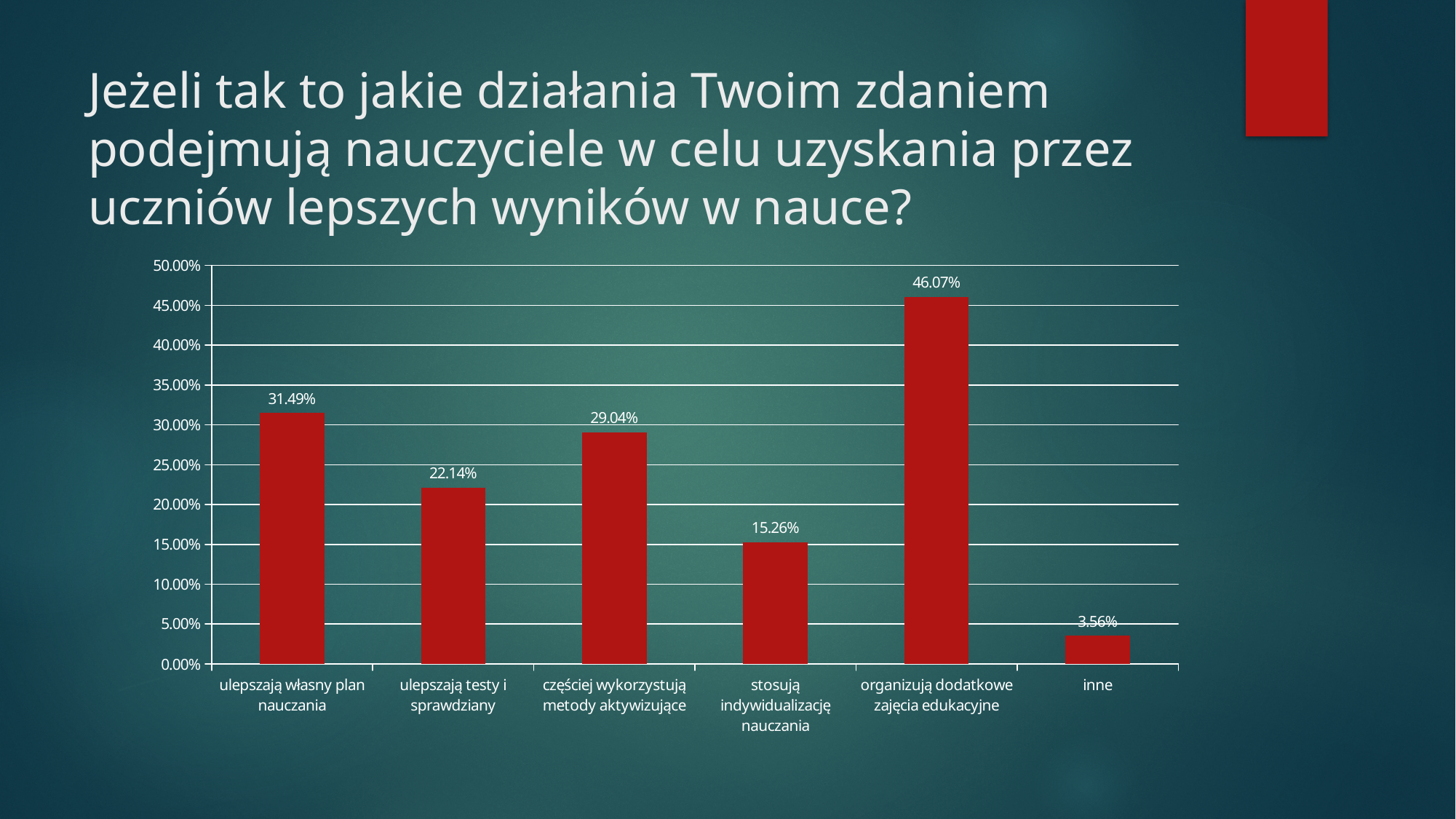
What is the difference between "ulepszają własny plan nauczania" and "częściej wykorzystują metody aktywizujące"? 2.45% What kind of chart is shown on the slide? bar chart Which category has the lowest value? inne What is the value for "inne"? 3.56% What is the value for "ulepszają testy i sprawdziany"? 22.14% What is the value for "stosują indywidualizację nauczania"? 15.26% How many categories are shown on the chart? 6 What is the value for "organizują dodatkowe zajęcia edukacyjne"? 46.07% Which is larger: "ulepszają testy i sprawdziany" or "stosują indywidualizację nauczania"? ulepszają testy i sprawdziany Which category has the highest value? organizują dodatkowe zajęcia edukacyjne Is the value for "ulepszają własny plan nauczania" greater or less than 30.00%? greater What is the maximum value shown on the vertical axis? 50.00%